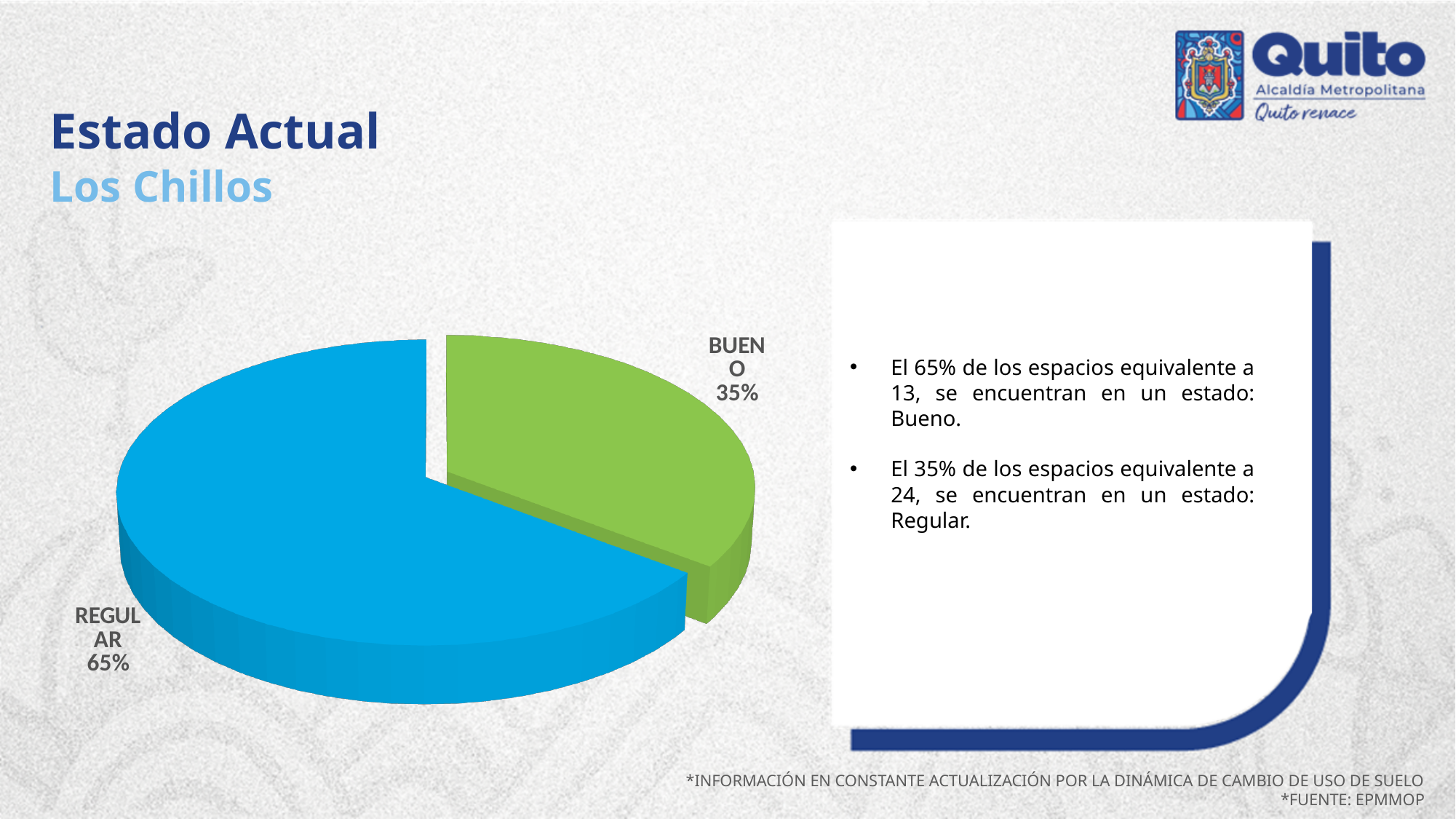
What colour is the BUENO slice of the pie chart? Green Is the value for BUENO greater or less than 50%? less What share of the pie does the REGULAR slice represent? 65% Which slice of the pie chart is the smallest? BUENO What share of the pie does the BUENO slice represent? 35% What is the difference in percentage points between the REGULAR and BUENO slices? 30% How many slices does the pie chart have? 2 What colour is the REGULAR slice of the pie chart? Blue What kind of chart is shown on the slide? Pie chart Which is larger, the BUENO slice or the REGULAR slice? REGULAR Is the value for REGULAR greater or less than 50%? greater Which slice of the pie chart is the largest? REGULAR